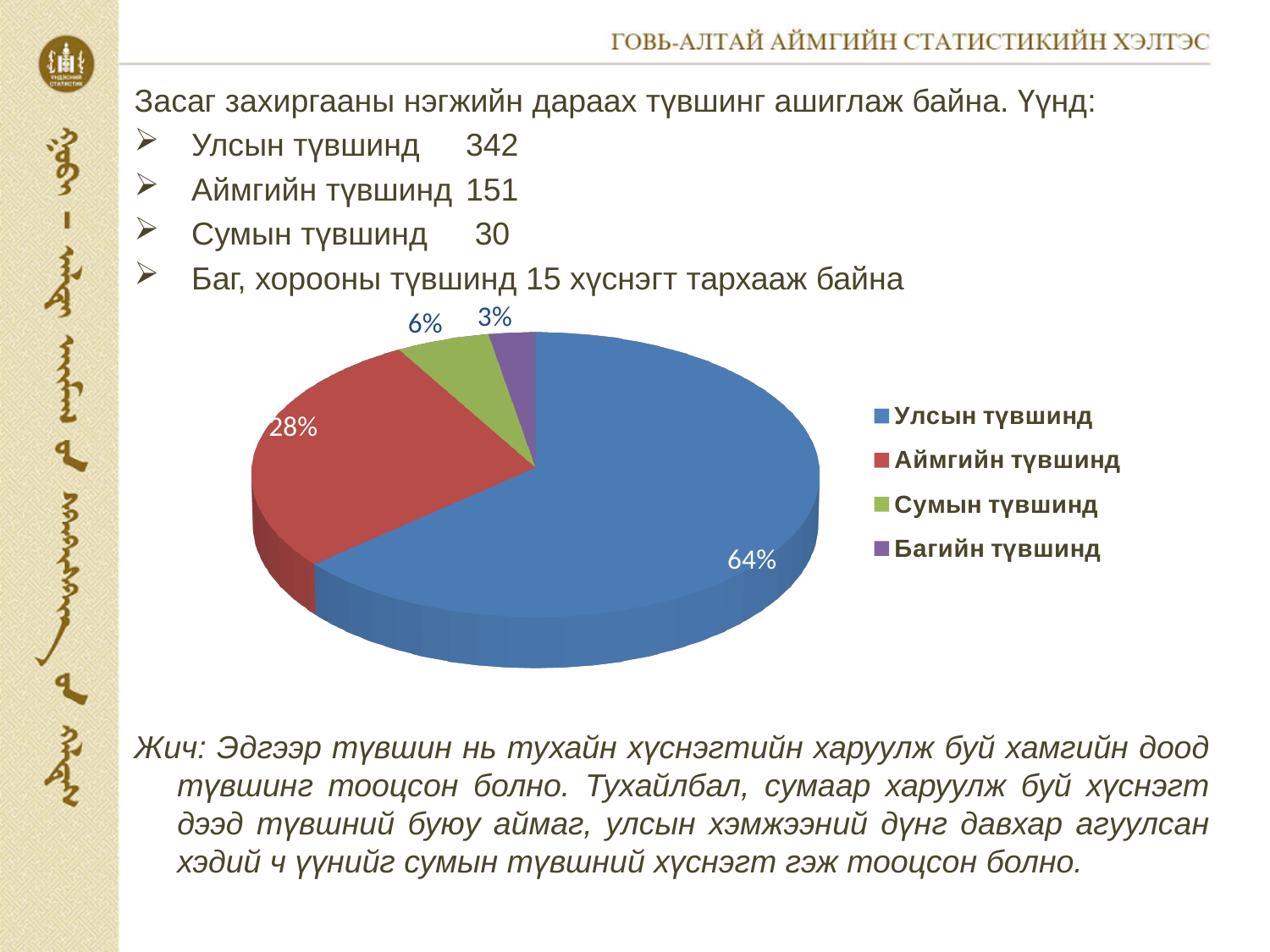
What share of the pie does Аймгийн түвшинд have? 28% Which slice is larger, Сумын түвшинд or Багийн түвшинд? Сумын түвшинд What colour is the Аймгийн түвшинд slice in the pie chart? red What share of the pie does Багийн түвшинд have? 3% Which category has the smallest slice of the pie? Багийн түвшинд Which category has the largest slice of the pie? Улсын түвшинд What is the difference in percentage points between the Улсын түвшинд and Аймгийн түвшинд slices? 36 How many slices does the pie chart have? 4 What kind of chart is shown on the slide? pie chart How many entries does the legend list? 4 What share of the pie does Сумын түвшинд have? 6%